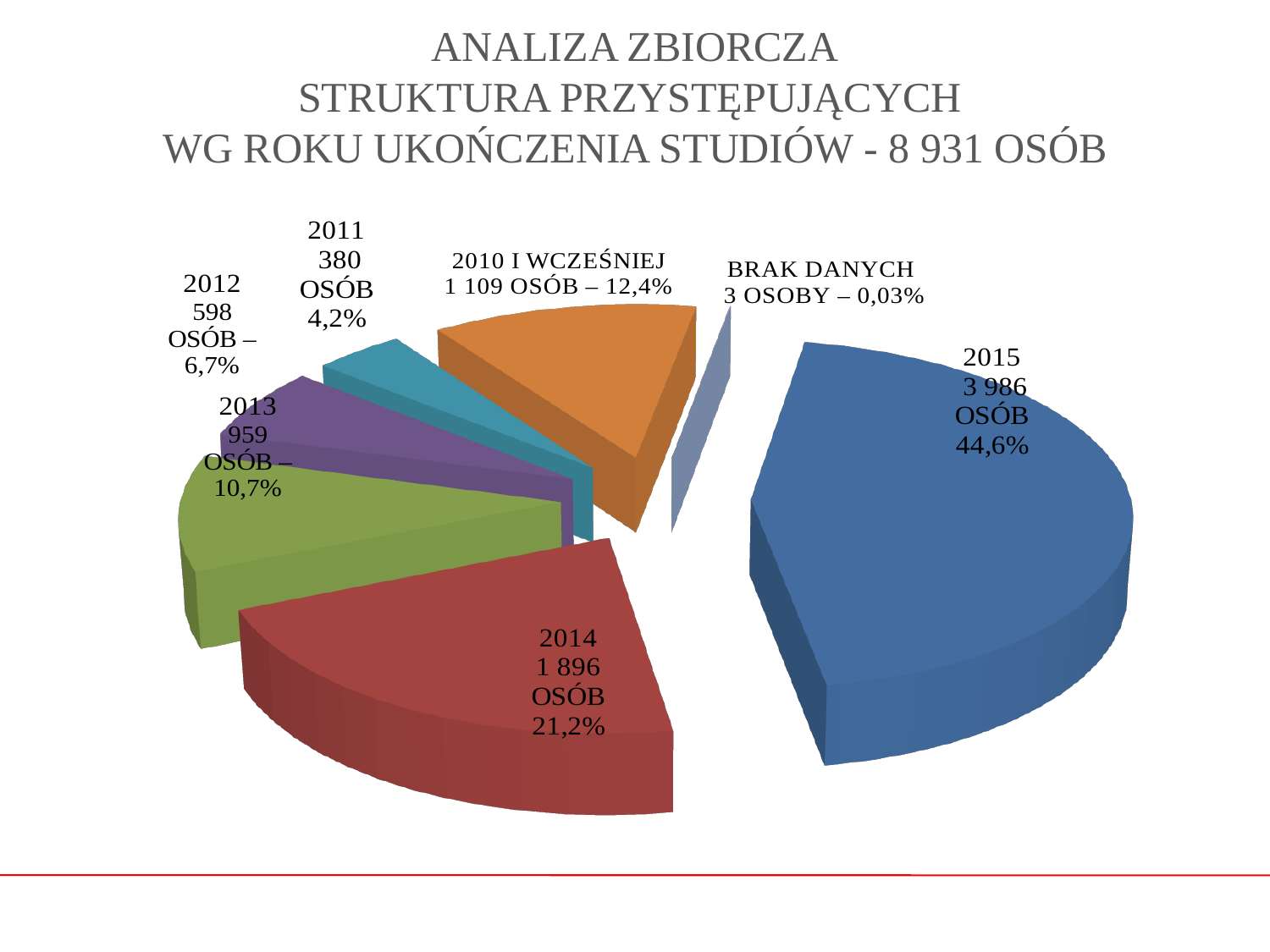
Which has more people, 2011 or 2012? 2012 What percentage is shown for the 2012 slice? 6,7% How many people are shown for the category 2010 I WCZEŚNIEJ? 1 109 Which category has the smallest slice of the pie? BRAK DANYCH What percentage is shown for BRAK DANYCH? 0,03% What kind of chart is shown on the slide? pie chart How many people are shown for 2013? 959 What is the difference in number of people between 2015 and 2014? 2 090 How many people (OSÓB) are shown for 2015? 3 986 How many slices does the pie chart have? 7 Which category has the largest slice of the pie? 2015 What percentage share does the 2014 slice have? 21,2%